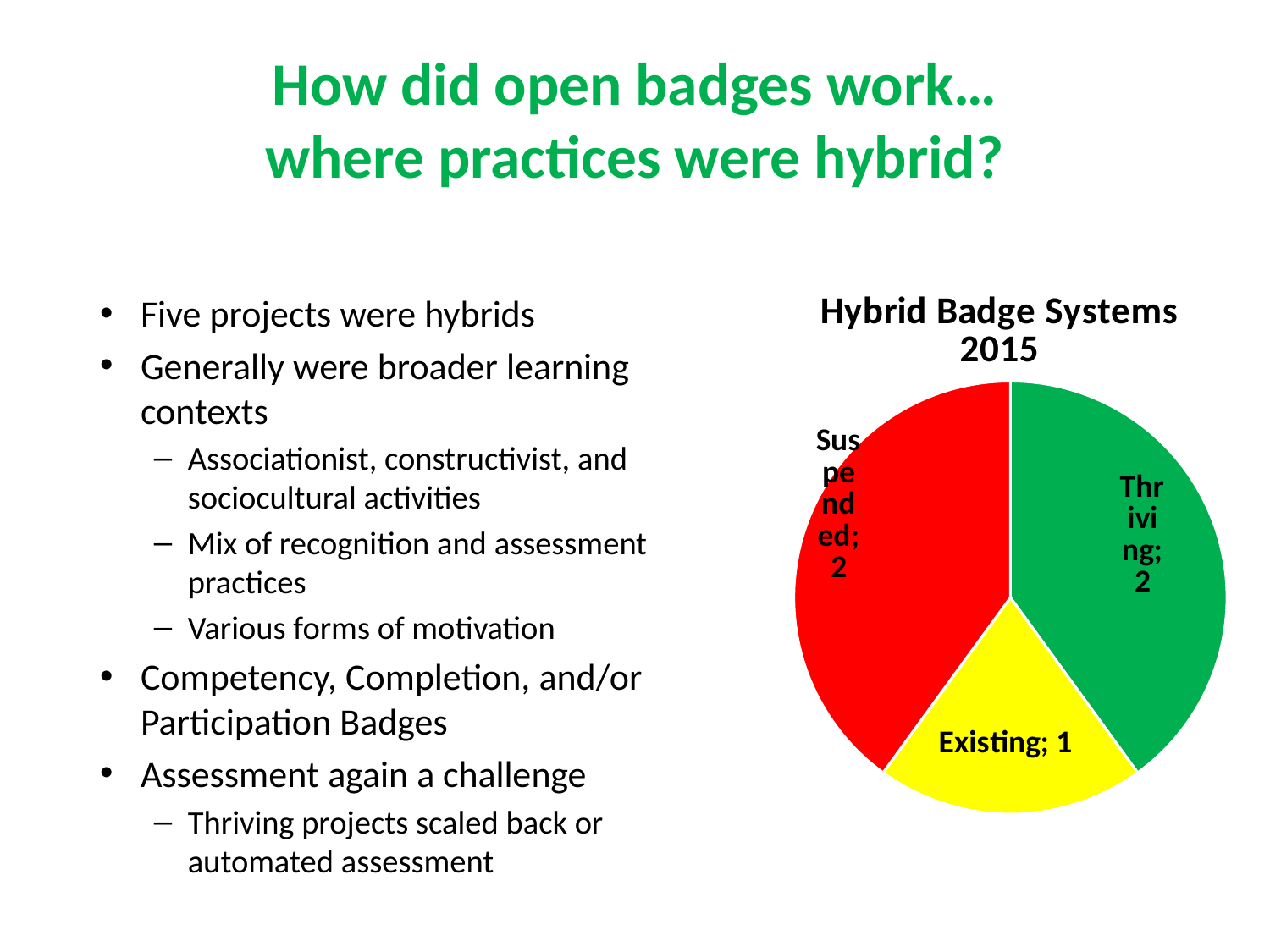
What is the value for Thriving in the Hybrid Badge Systems 2015 pie chart? 2 Which is larger in the Hybrid Badge Systems 2015 pie chart, Suspended or Existing? Suspended What is the value for Existing in the Hybrid Badge Systems 2015 pie chart? 1 What is the value for Suspended in the Hybrid Badge Systems 2015 pie chart? 2 What kind of chart is shown on the slide? Pie chart What is the title of the pie chart on the slide? Hybrid Badge Systems 2015 What is the difference between the Thriving and Existing values in the Hybrid Badge Systems 2015 pie chart? 1 What share of the Hybrid Badge Systems 2015 pie does the Thriving slice represent? 40% Which category has the lowest value in the Hybrid Badge Systems 2015 pie chart? Existing How many slices does the Hybrid Badge Systems 2015 pie chart have? 3 What share of the Hybrid Badge Systems 2015 pie does the Existing slice represent? 20% What is the total of all slices in the Hybrid Badge Systems 2015 pie chart? 5